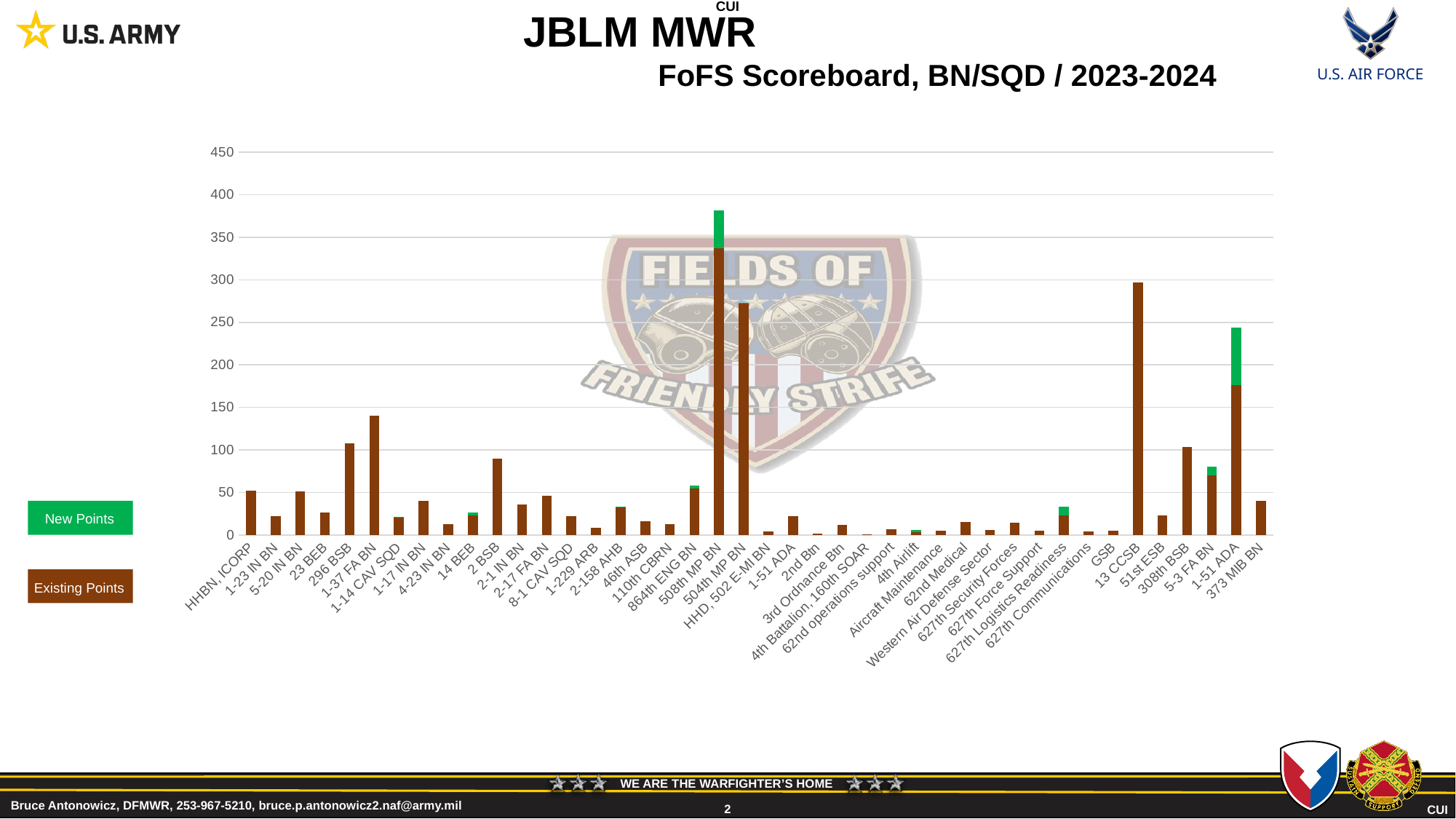
Is the total value for 1-51 ADA (the bar next to 373 MIB BN) greater or less than 200? greater Is the value for 1-37 FA BN greater or less than 100? greater What colour represents New Points in the legend? green Which is larger, the bar for 13 CCSB or the bar for 504th MP BN? 13 CCSB What kind of chart is shown on the slide? bar chart Which category has the highest total bar? 508th MP BN What is the highest value shown on the vertical axis? 450 Is the value for 13 CCSB greater or less than 250? greater Which is larger, the bar for 1-37 FA BN or the bar for 296 BSB? 1-37 FA BN How many series does the legend list? 2